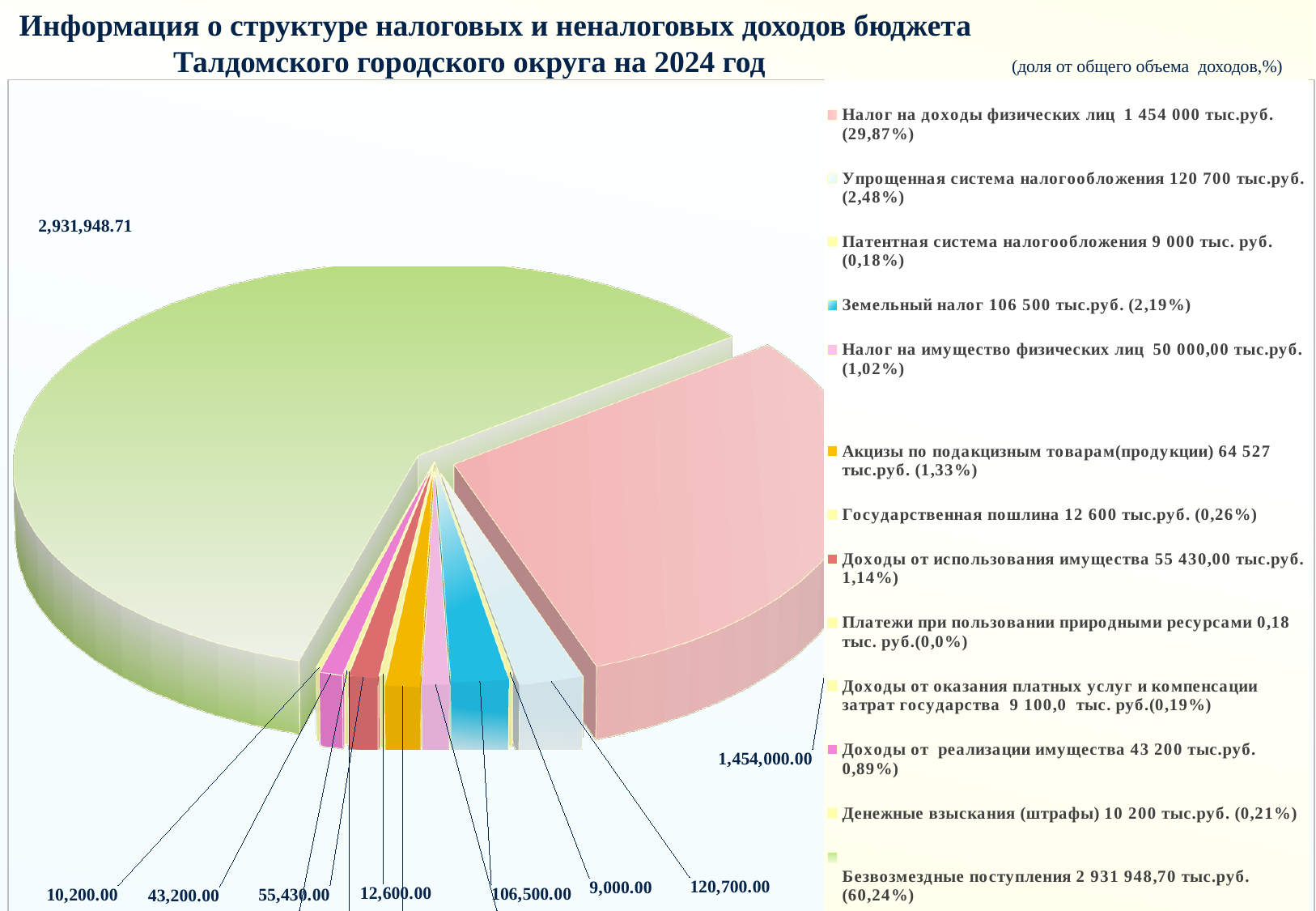
How many entries does the legend of the pie chart list? 13 What year does the chart title say the budget revenue structure refers to? 2024 What is the data label on the slice for Налог на доходы физических лиц? 1,454,000.00 Which legend category has the smallest value? Платежи при пользовании природными ресурсами What is the difference between the data labels for Упрощенная система налогообложения (120,700.00) and Земельный налог (106,500.00)? 14,200.00 What share of total revenue do Безвозмездные поступления make up according to the legend? 60,24% What percentage share is given in the legend for Земельный налог? 2,19% What kind of chart is shown on the slide? pie chart What percentage share is given in the legend for Акцизы по подакцизным товарам (продукции)? 1,33% Which category has the largest share of the pie? Безвозмездные поступления Which is larger: the value for Упрощенная система налогообложения or the value for Земельный налог? Упрощенная система налогообложения